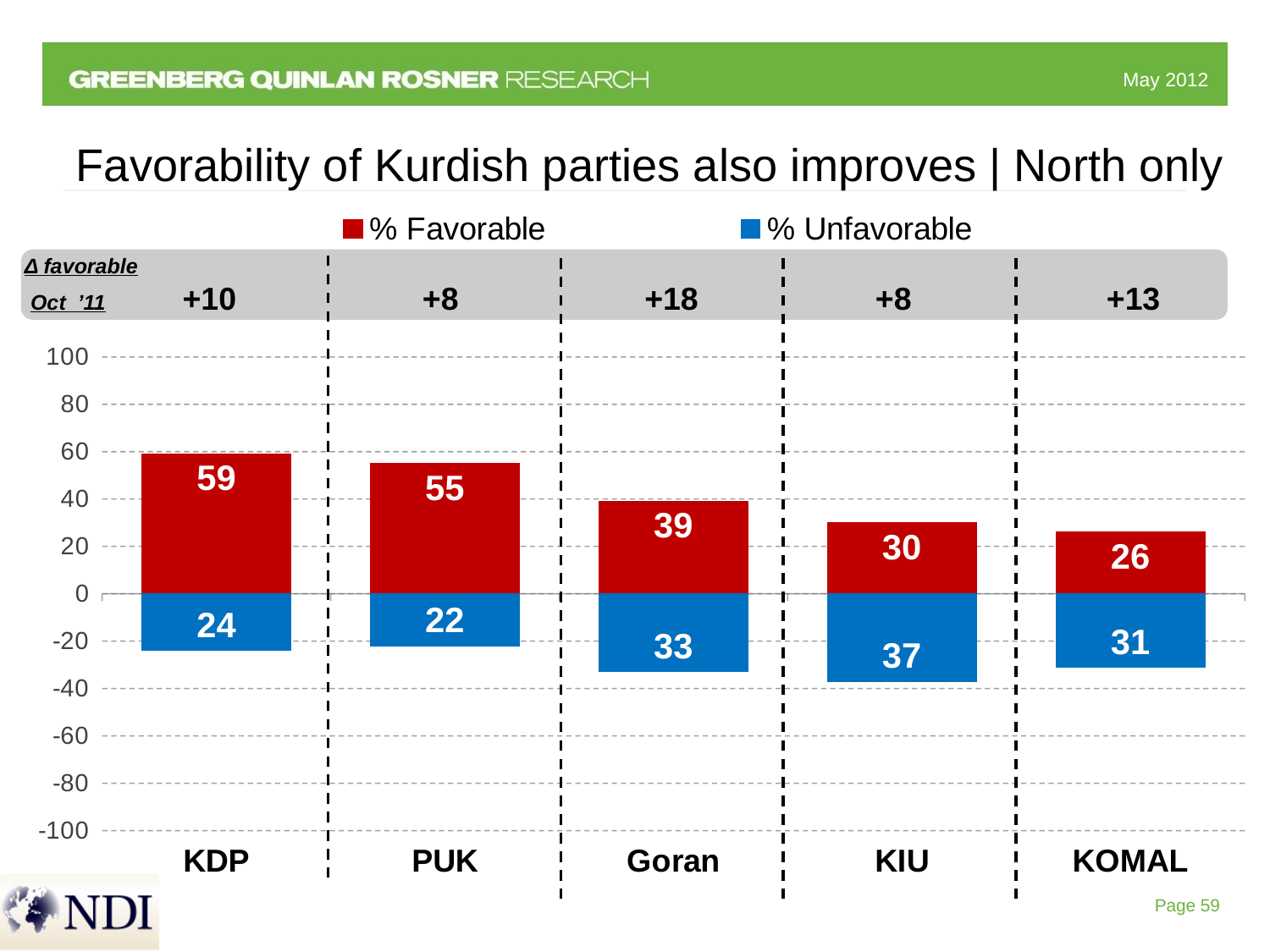
What kind of chart is shown on the slide? Bar chart What is the % Favorable value for KDP? 59 What is the % Unfavorable value for KIU? 37 Which is larger for KOMAL, the % Favorable or the % Unfavorable value? % Unfavorable How many parties are shown on the x axis? 5 How many series does the legend list? 2 Which party has the highest % Favorable value? KDP What is the % Favorable value for Goran? 39 Which party has the lowest % Unfavorable value? PUK Which party has the lowest % Favorable value? KOMAL What is the difference between the % Favorable and % Unfavorable values for PUK? 33 What is the Δ favorable value since Oct '11 shown above Goran? +18